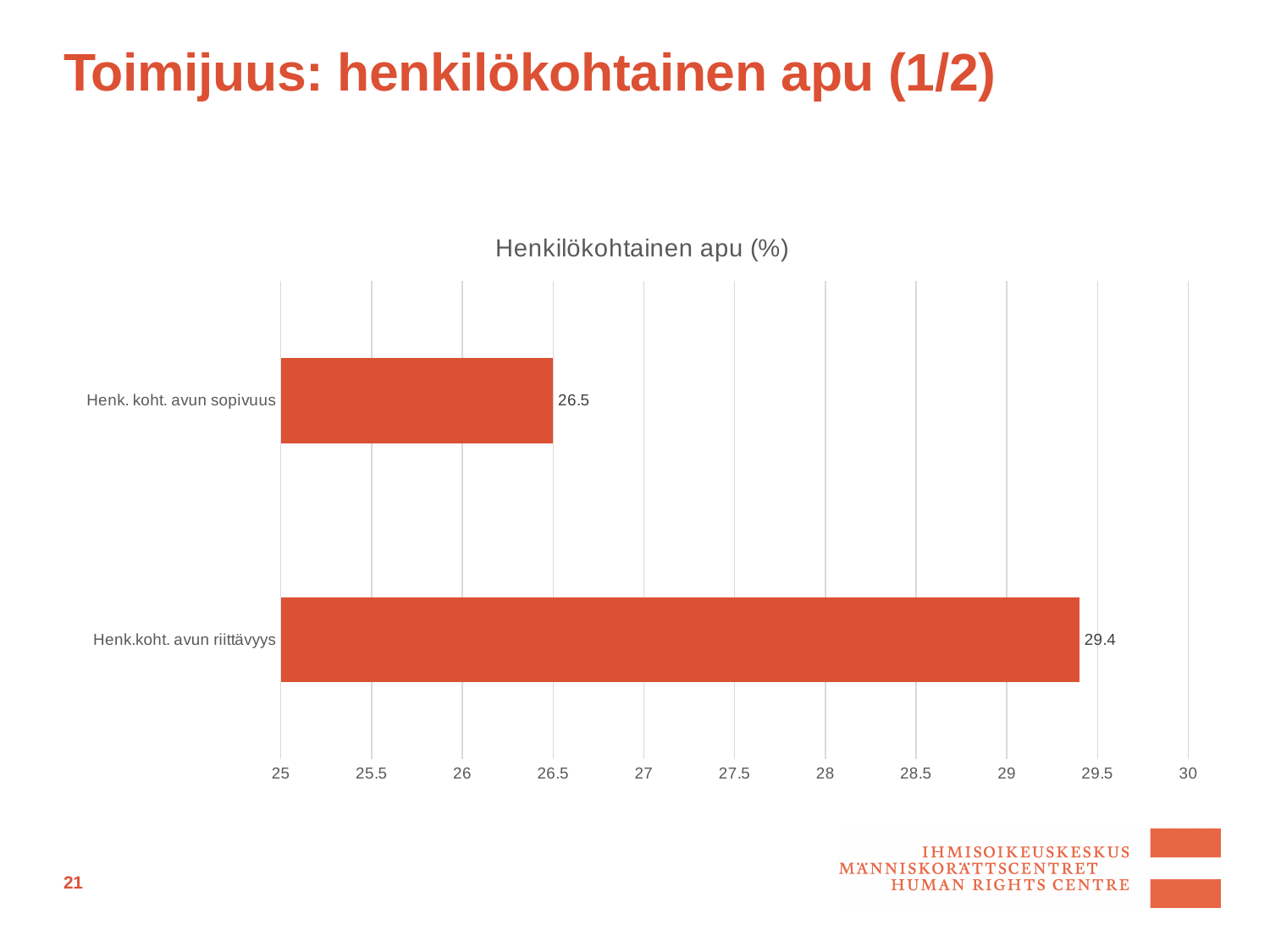
What is the value for Henk.koht. avun riittävyys? 29.4 What is the title of the chart? Henkilökohtainen apu (%) Is the value for Henk.koht. avun riittävyys greater or less than 28? greater Which category has the highest value? Henk.koht. avun riittävyys What kind of chart is shown on the slide? Bar chart What is the value for Henk. koht. avun sopivuus? 26.5 Which category has the lowest value? Henk. koht. avun sopivuus Which is larger, the value for Henk. koht. avun sopivuus or the value for Henk.koht. avun riittävyys? Henk.koht. avun riittävyys How many categories are shown in the chart? 2 What is the difference between the values for Henk.koht. avun riittävyys and Henk. koht. avun sopivuus? 2.9 What is the maximum value shown on the horizontal axis? 30 Is the value for Henk. koht. avun sopivuus greater or less than 27? less